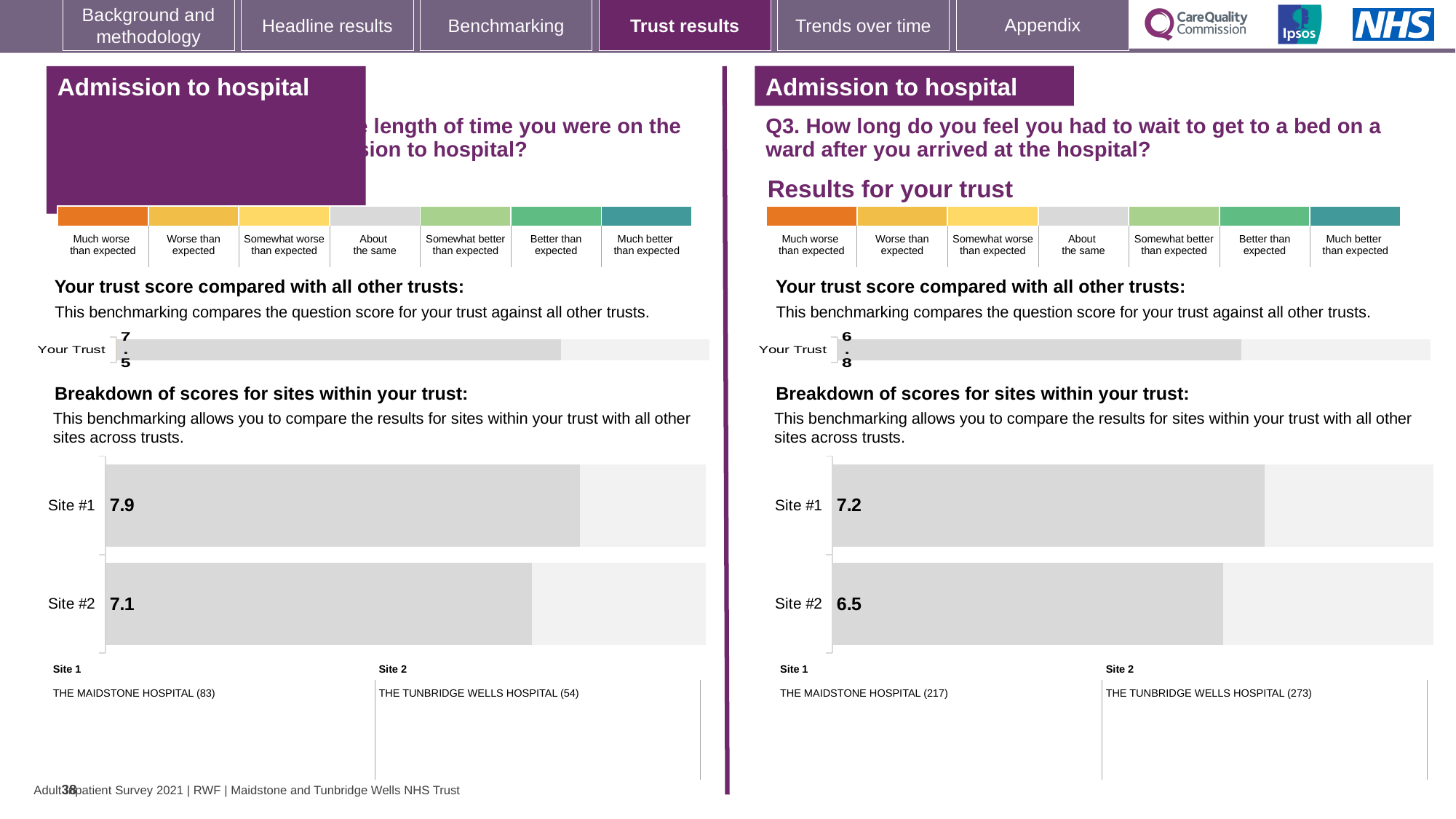
On the left-hand side of the slide, what is the difference between the Site #1 and Site #2 scores in the site breakdown chart? 0.8 In the Q3 chart (wait to get to a bed on a ward), what is the difference between the Site #1 and Site #2 scores? 0.7 On the left-hand side of the slide, what is the score shown for Site #1 in the breakdown of scores for sites within your trust? 7.9 In the Q3 chart (wait to get to a bed on a ward), what is the score shown for Site #2? 6.5 In the Q3 chart (wait to get to a bed on a ward), what is the score shown for Site #1? 7.2 On the left-hand side of the slide, what is the score shown for Site #2 in the breakdown of scores for sites within your trust? 7.1 In the Q3 chart (wait to get to a bed on a ward), what is the 'Your Trust' score in the trust score comparison chart? 6.8 On the left-hand side of the slide, which site has the higher score in the site breakdown chart? Site #1 What type of chart is used for the breakdown of scores for sites within your trust on the left-hand side of the slide? Bar chart How many sites are shown in the site breakdown chart on the right-hand side of the slide? 2 In the Q3 chart (wait to get to a bed on a ward), which site has the lower score in the site breakdown chart? Site #2 On the left-hand side of the slide, what is the 'Your Trust' score in the trust score comparison chart? 7.5